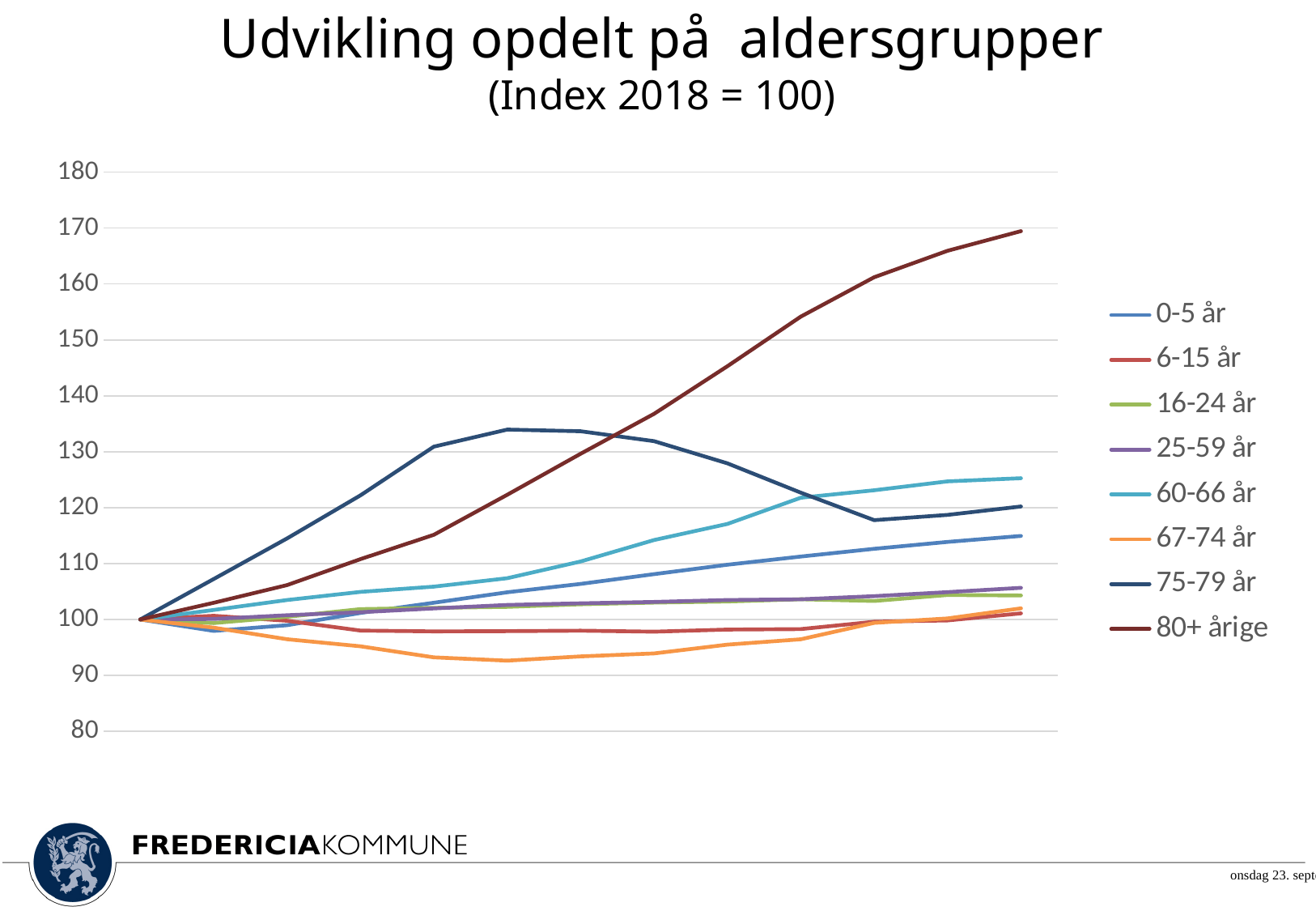
Does the 80+ årige series rise or fall from left to right? rise Which is larger at the right end of the chart, the value for 60-66 år or the value for 0-5 år? 60-66 år Which age group is listed last in the legend? 80+ årige Is the lowest value for 67-74 år greater or less than 95? less What is the title of the chart? Udvikling opdelt på aldersgrupper (Index 2018 = 100) How many series does the legend list? 8 Is the peak value for 75-79 år greater or less than 130? greater Is the final value for 80+ årige greater or less than 160? greater Which series has the highest value at the right end of the chart? 80+ årige What kind of chart is shown on the slide? line chart At what index value do all the series start on the left of the chart? 100 Which series reaches the lowest value anywhere on the chart? 67-74 år